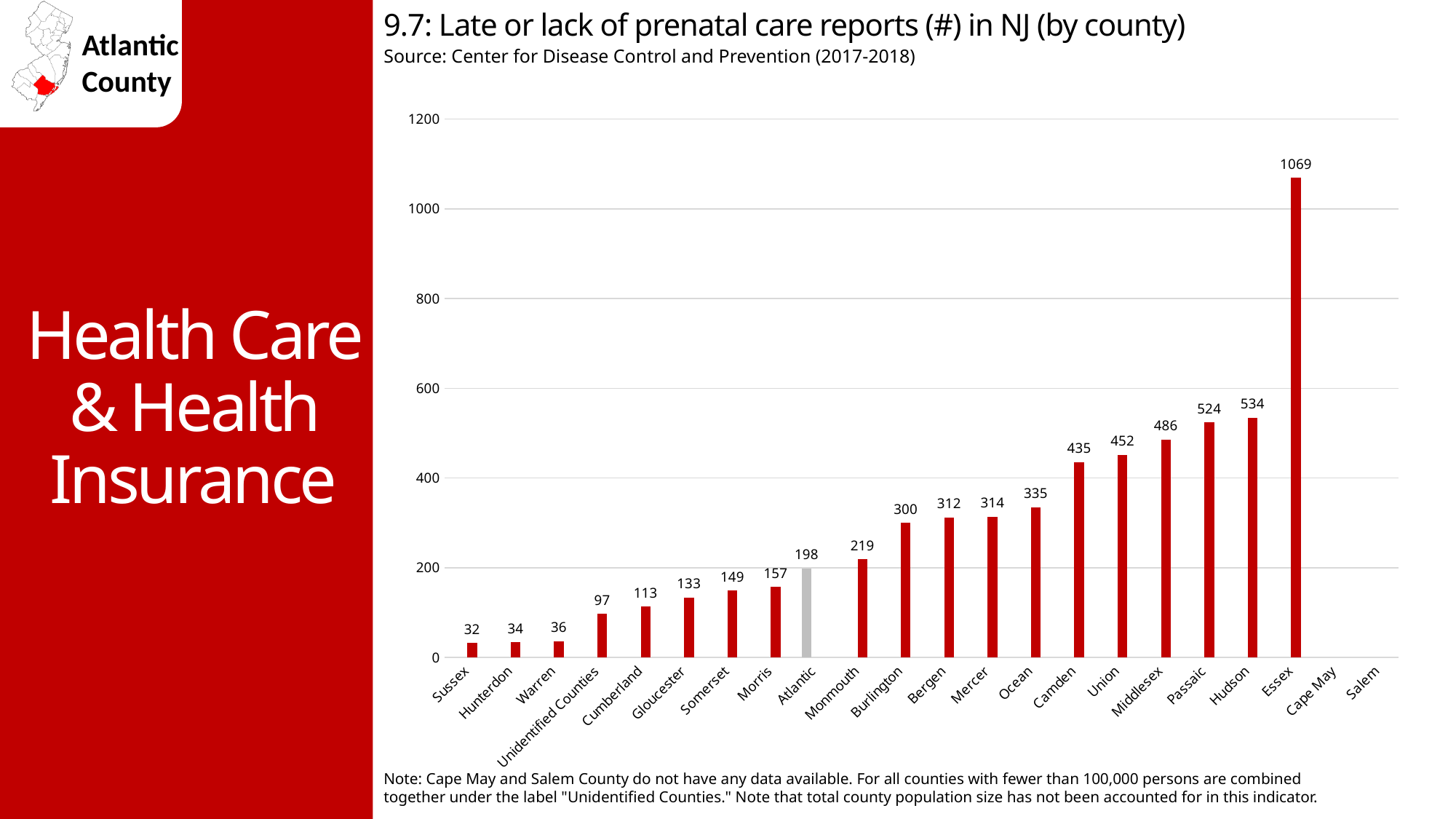
Is the value for Passaic greater or less than 600? less What is the number of late or lack of prenatal care reports for Atlantic County? 198 Which county has the lowest number of reports shown on the chart? Sussex Do the values generally rise or fall moving from left to right along the x axis? rise What is the difference between the values for Essex and Hudson? 535 Which county has the highest number of late or lack of prenatal care reports? Essex Which has a larger value, Camden or Ocean? Camden How much higher is the value for Atlantic than the value for Morris? 41 How many counties or categories are labelled along the x axis? 22 What is the value shown for Middlesex? 486 What kind of chart is shown on the slide? bar chart Which county's bar is coloured grey instead of red? Atlantic